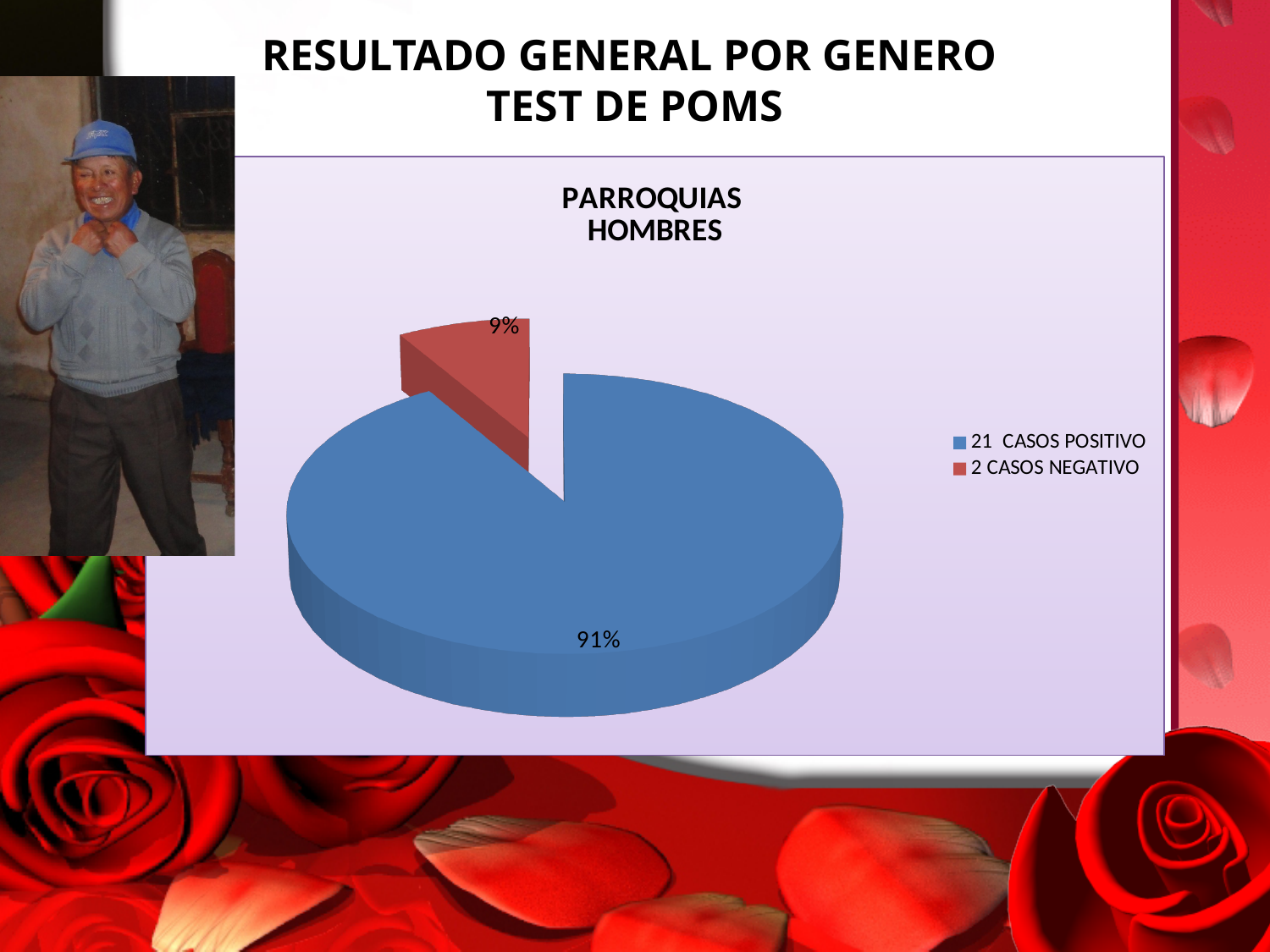
What is the title of the chart? PARROQUIAS HOMBRES Which slice is the smallest in the pie chart? 2 CASOS NEGATIVO Which slice is larger, '21 CASOS POSITIVO' or '2 CASOS NEGATIVO'? 21 CASOS POSITIVO What percentage share does the '21 CASOS POSITIVO' slice have? 91% What percentage share does the '2 CASOS NEGATIVO' slice have? 9% What kind of chart is shown on the slide? Pie chart How many slices does the pie chart have? 2 How many entries does the legend list? 2 Which slice is the largest in the pie chart? 21 CASOS POSITIVO What is the difference in percentage points between the '21 CASOS POSITIVO' slice and the '2 CASOS NEGATIVO' slice? 82 percentage points What colour is the '2 CASOS NEGATIVO' slice? Red